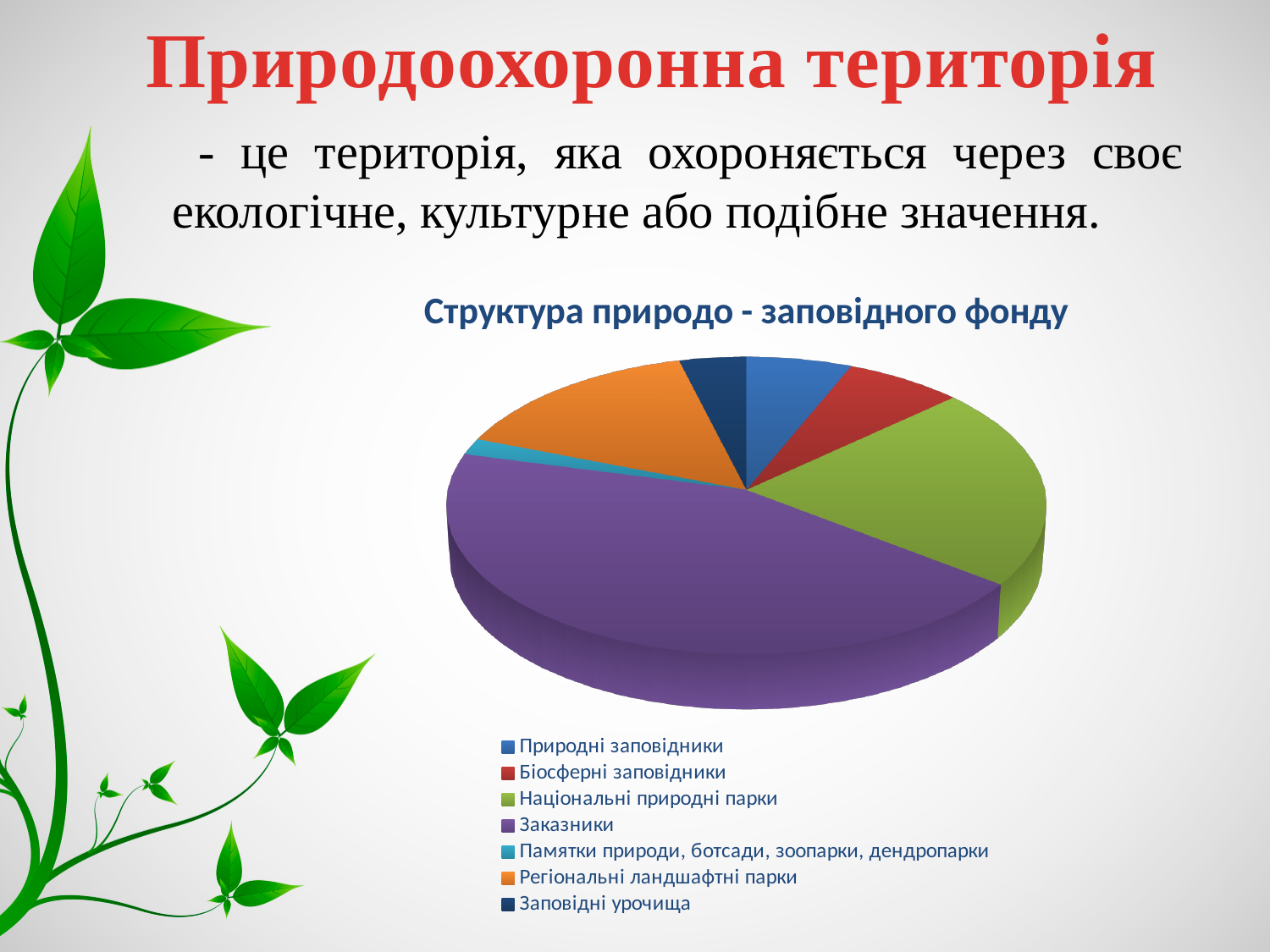
What colour is the slice for Заказники? purple Which slice is larger: Регіональні ландшафтні парки or Памятки природи, ботсади, зоопарки, дендропарки? Регіональні ландшафтні парки Which category has the largest slice of the pie? Заказники Which slice is larger: Національні природні парки or Природні заповідники? Національні природні парки What kind of chart is shown on the slide? pie chart Which slice is larger: Регіональні ландшафтні парки or Біосферні заповідники? Регіональні ландшафтні парки Which category is the second largest slice of the pie? Національні природні парки How many categories (slices) does the pie chart have? 7 What is the title of the chart? Структура природо - заповідного фонду Which category has the smallest slice of the pie? Памятки природи, ботсади, зоопарки, дендропарки